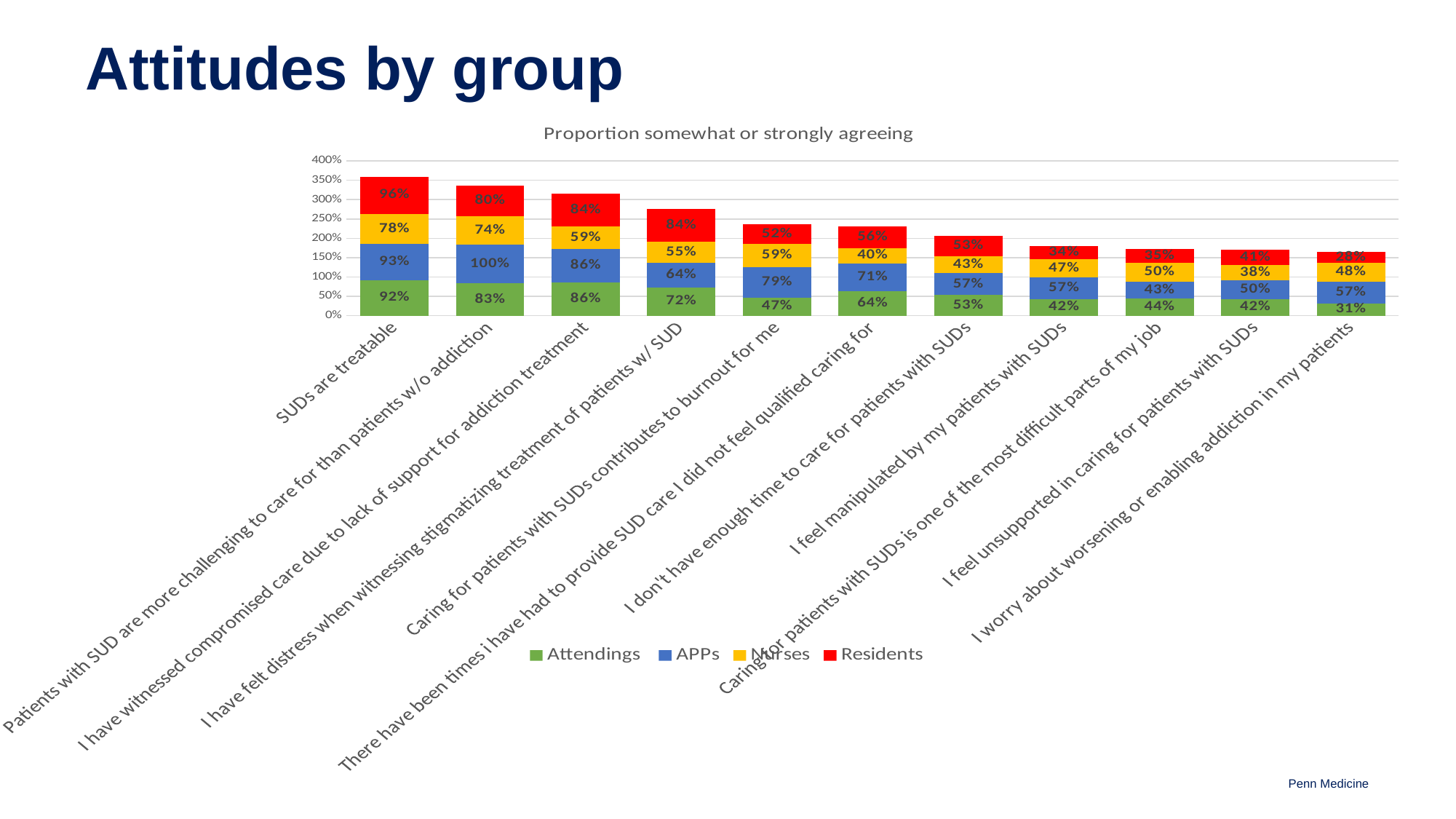
How many categories (statements) are plotted on the x axis? 11 What is the total of the stacked bar for "SUDs are treatable"? 359% How many series does the legend list? 4 What is the value for APPs for "Patients with SUD are more challenging to care for than patients w/o addiction"? 100% What is the value for Residents for "SUDs are treatable"? 96% For "I feel manipulated by my patients with SUDs", which is larger: the APPs value or the Residents value? APPs Which statement has the lowest Residents value? I worry about worsening or enabling addiction in my patients What is the value for Attendings for "I worry about worsening or enabling addiction in my patients"? 31% What type of chart is shown on the slide? Stacked bar chart Which statement has the highest Attendings value? SUDs are treatable What is the value for Nurses for "Caring for patients with SUDs contributes to burnout for me"? 59% What is the difference between the APPs and Attendings values for "Caring for patients with SUDs contributes to burnout for me"? 32%